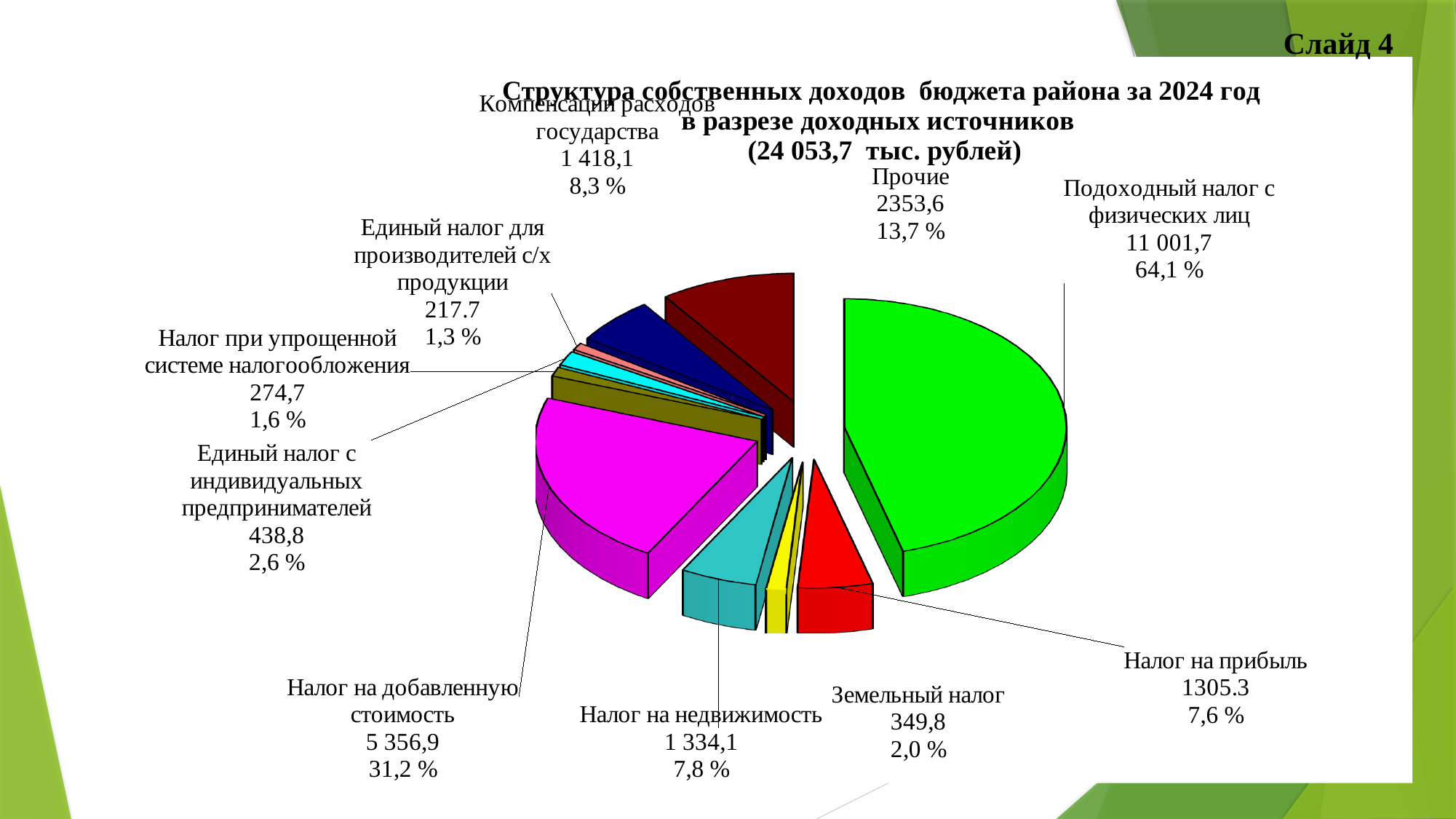
What is the difference between the values for Прочие and Компенсации расходов государства? 935,5 What is the difference between the values for Налог на недвижимость and Налог на прибыль? 28,8 What total amount in thousand rubles is given in the chart title? 24 053,7 Which income source has the smallest value? Единый налог для производителей с/х продукции What percentage is shown for Прочие? 13,7 % What is the value shown for Земельный налог? 349,8 What kind of chart is shown on the slide? Pie chart What percentage is shown for Налог на добавленную стоимость? 31,2 % Which is larger: Земельный налог or Налог при упрощенной системе налогообложения? Земельный налог How many income sources are shown in the pie chart? 10 Which income source has the largest slice of the pie? Подоходный налог с физических лиц What is the value shown for Подоходный налог с физических лиц? 11 001,7